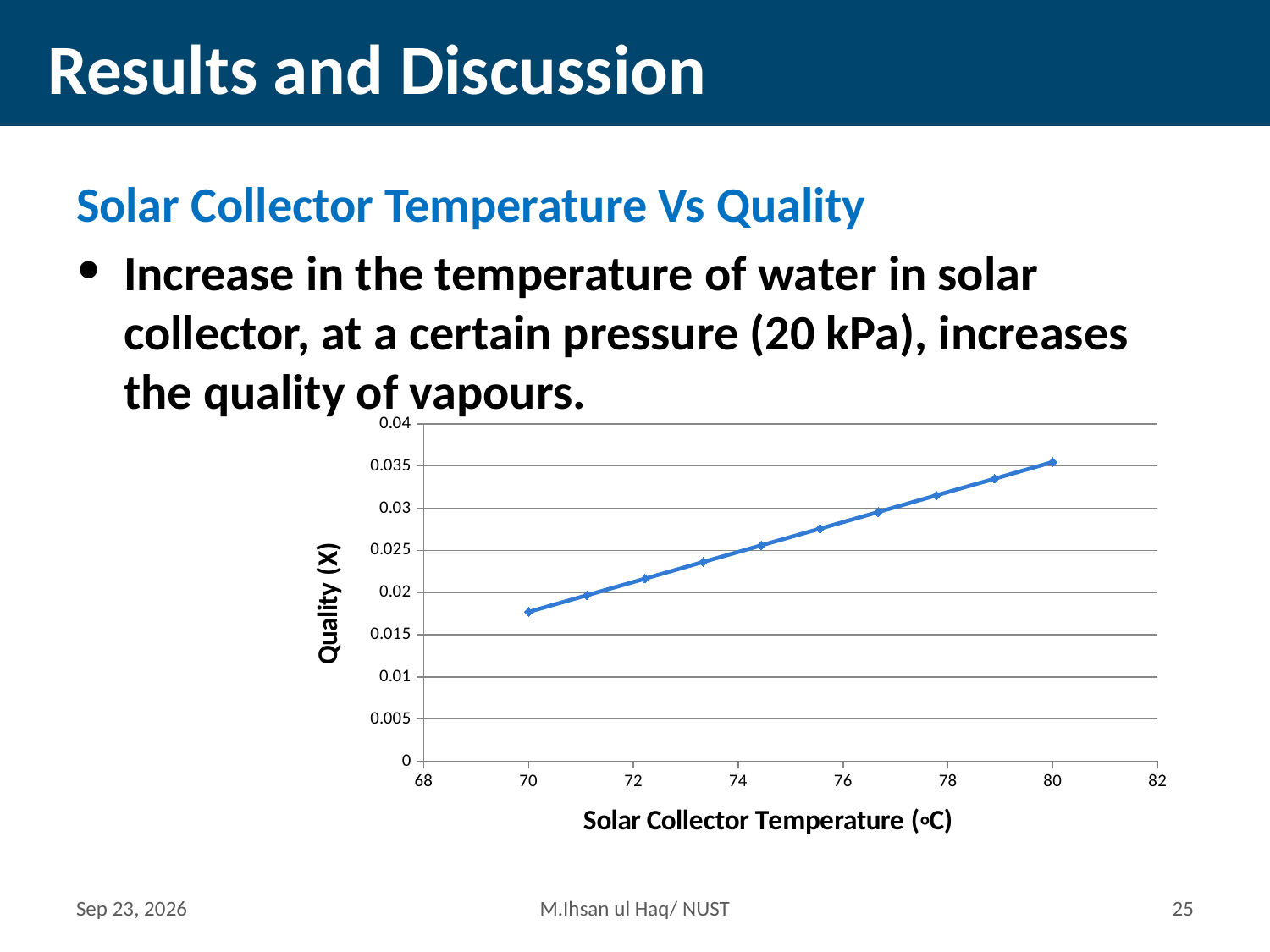
What is the title of the y axis of the chart? Quality (X) What kind of chart is shown on the slide? line chart Which has the larger quality value: the point at 70 or the point at 80? 80 What is the title of the x axis of the chart? Solar Collector Temperature (◦C) Is the quality at a solar collector temperature of 80 greater or less than 0.04? less Is the quality at a solar collector temperature of 80 greater or less than 0.03? greater Does the quality rise or fall as the solar collector temperature increases along the x axis? rise At which solar collector temperature is the quality highest? 80 At which solar collector temperature is the quality lowest? 70 How many data points are plotted on the line? 10 Is the quality at a solar collector temperature of 70 greater or less than 0.02? less